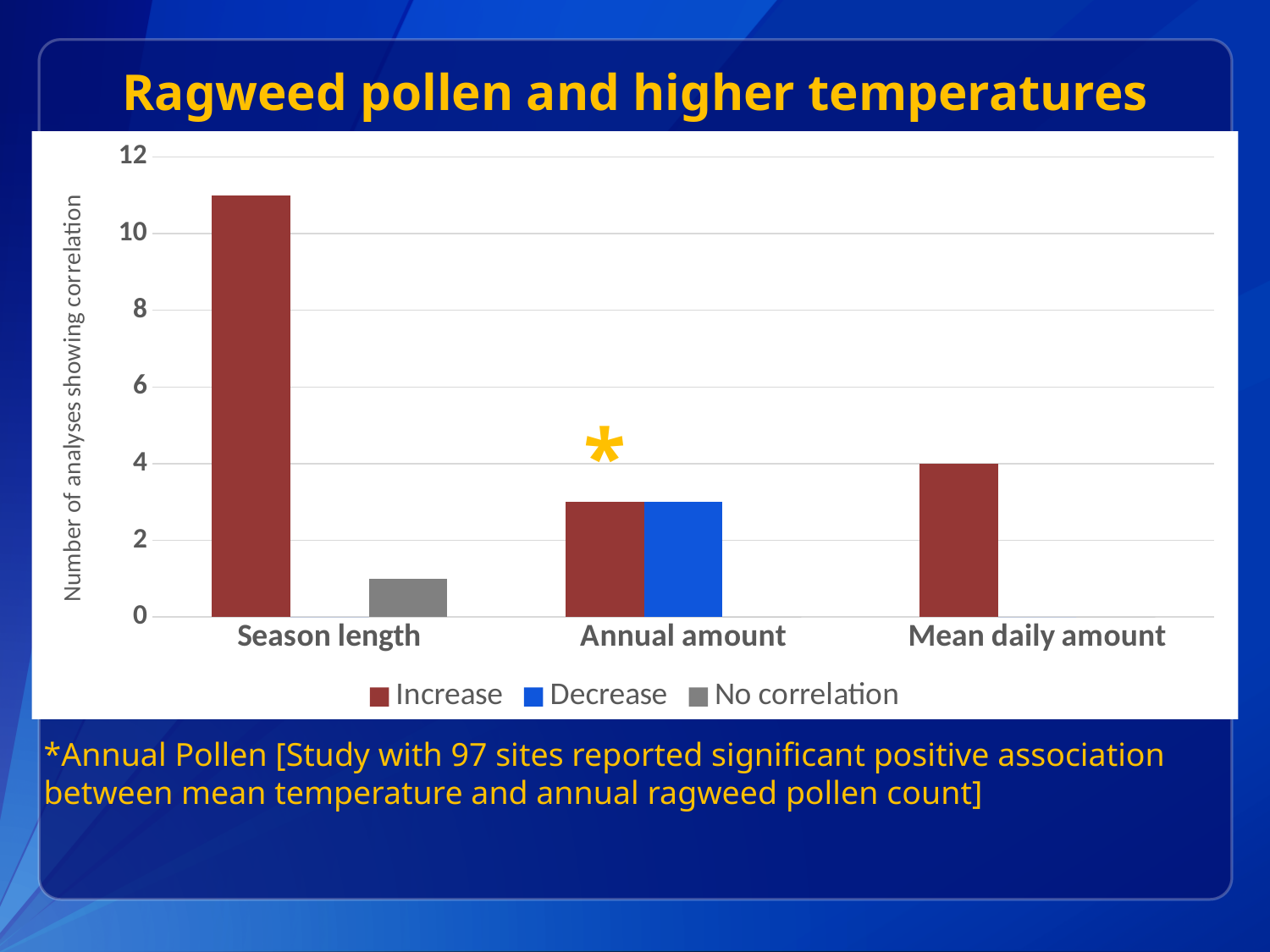
Is the No correlation value for Season length greater or less than 2? less Is the Decrease value for Annual amount greater or less than 4? less Which series is shown in blue in the legend? Decrease What type of chart is shown on the slide? Bar chart How many series does the legend list? 3 How many categories are shown on the x axis? 3 Which is larger, the Increase bar for Season length or the Increase bar for Mean daily amount? Season length Is the Increase value for Season length greater or less than 10? greater Which category has the lowest Increase bar? Annual amount What is the value of the Increase bar for Mean daily amount? 4 Which category has the highest Increase bar? Season length What is the title of the chart? Ragweed pollen and higher temperatures